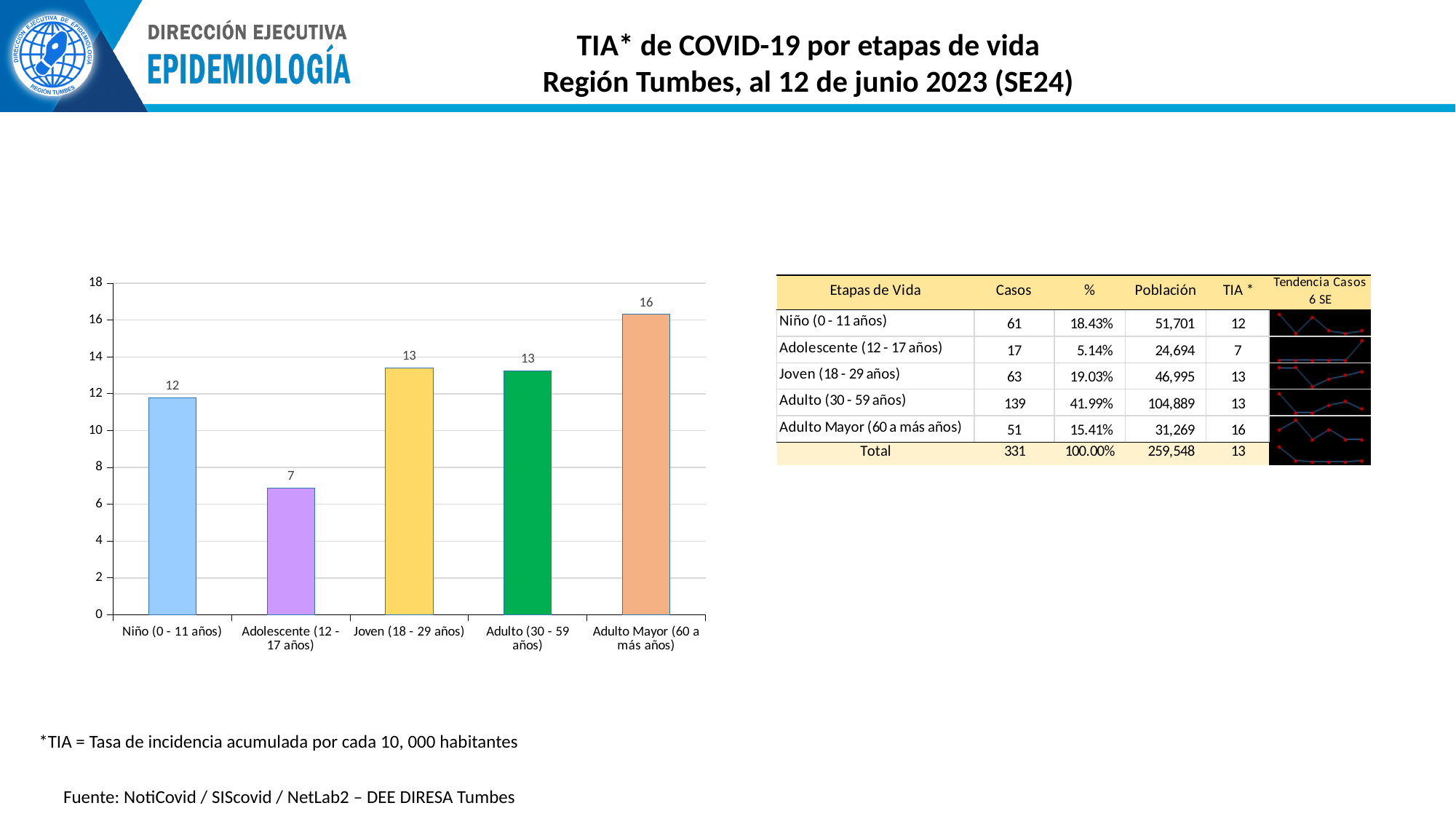
What is the difference between the TIA values for Adulto Mayor (60 a más años) and Adolescente (12 - 17 años)? 9 Is the TIA value for Adulto Mayor (60 a más años) greater or less than 14? greater What kind of chart is used to show TIA by life stage? bar chart Which has a larger TIA value, Niño (0 - 11 años) or Joven (18 - 29 años)? Joven (18 - 29 años) Which life stage has the highest TIA value in the bar chart? Adulto Mayor (60 a más años) What colour is the bar for Joven (18 - 29 años)? yellow What is the TIA value shown for Adulto Mayor (60 a más años) in the bar chart? 16 How many life-stage categories are shown in the bar chart? 5 What is the TIA value shown for Niño (0 - 11 años) in the bar chart? 12 Which life stage has the lowest TIA value in the bar chart? Adolescente (12 - 17 años) What is the TIA value shown for Adolescente (12 - 17 años) in the bar chart? 7 Is the TIA value for Adolescente (12 - 17 años) greater or less than 8? less